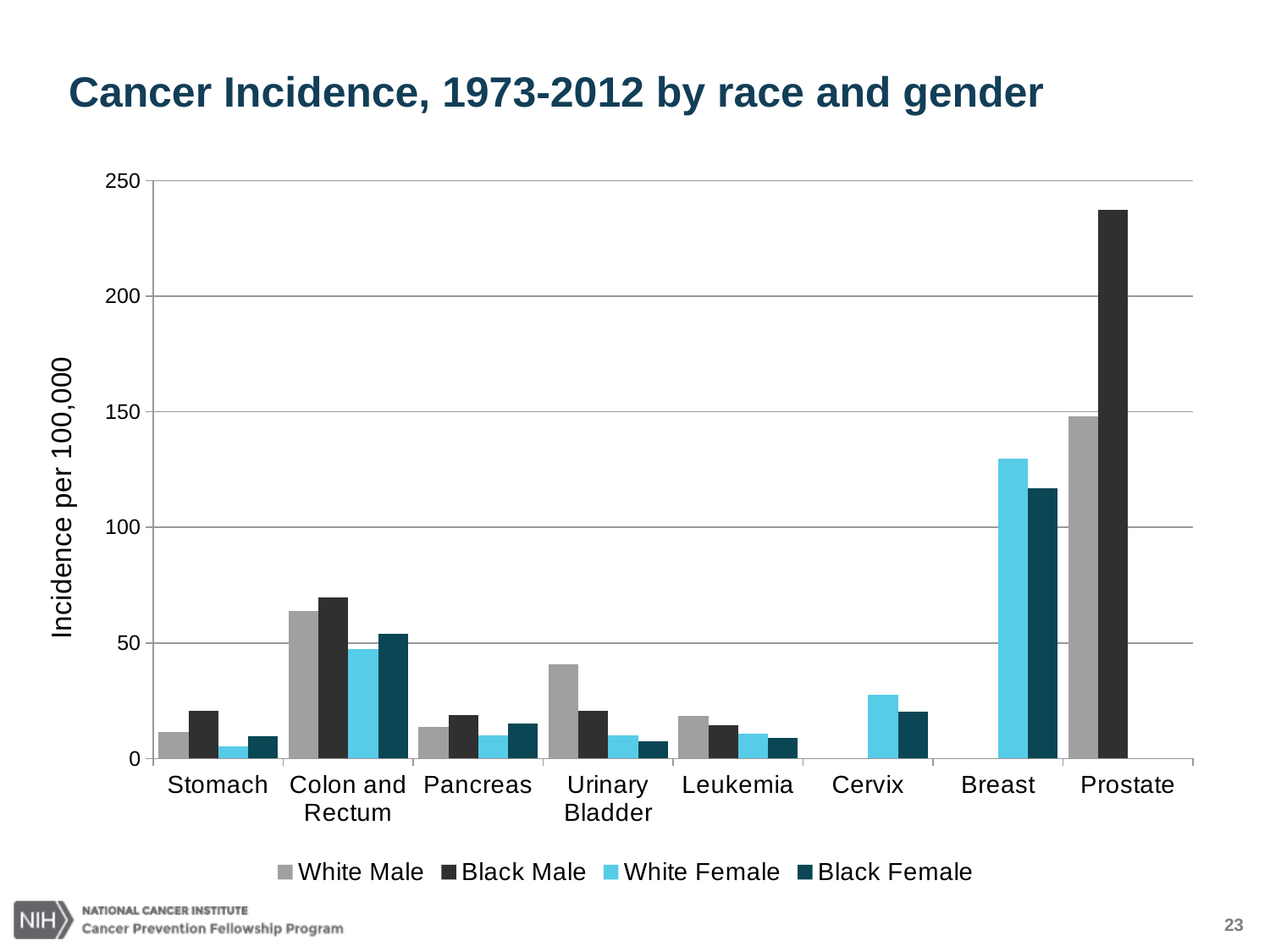
Is the Black Male value for Colon and Rectum greater or less than 50? greater Is the White Male value for Prostate greater or less than 100? greater For Breast, which is larger: the White Female value or the Black Female value? White Female Which series has the lowest value for Stomach? White Female For Urinary Bladder, which is larger: the White Male value or the Black Male value? White Male How many series does the legend list? 4 Is the White Female value for Breast greater or less than 100? greater What kind of chart is shown on the slide? Bar chart What is the label on the y axis? Incidence per 100,000 Which cancer type has the highest Black Male incidence? Prostate How many cancer types are shown on the x axis? 8